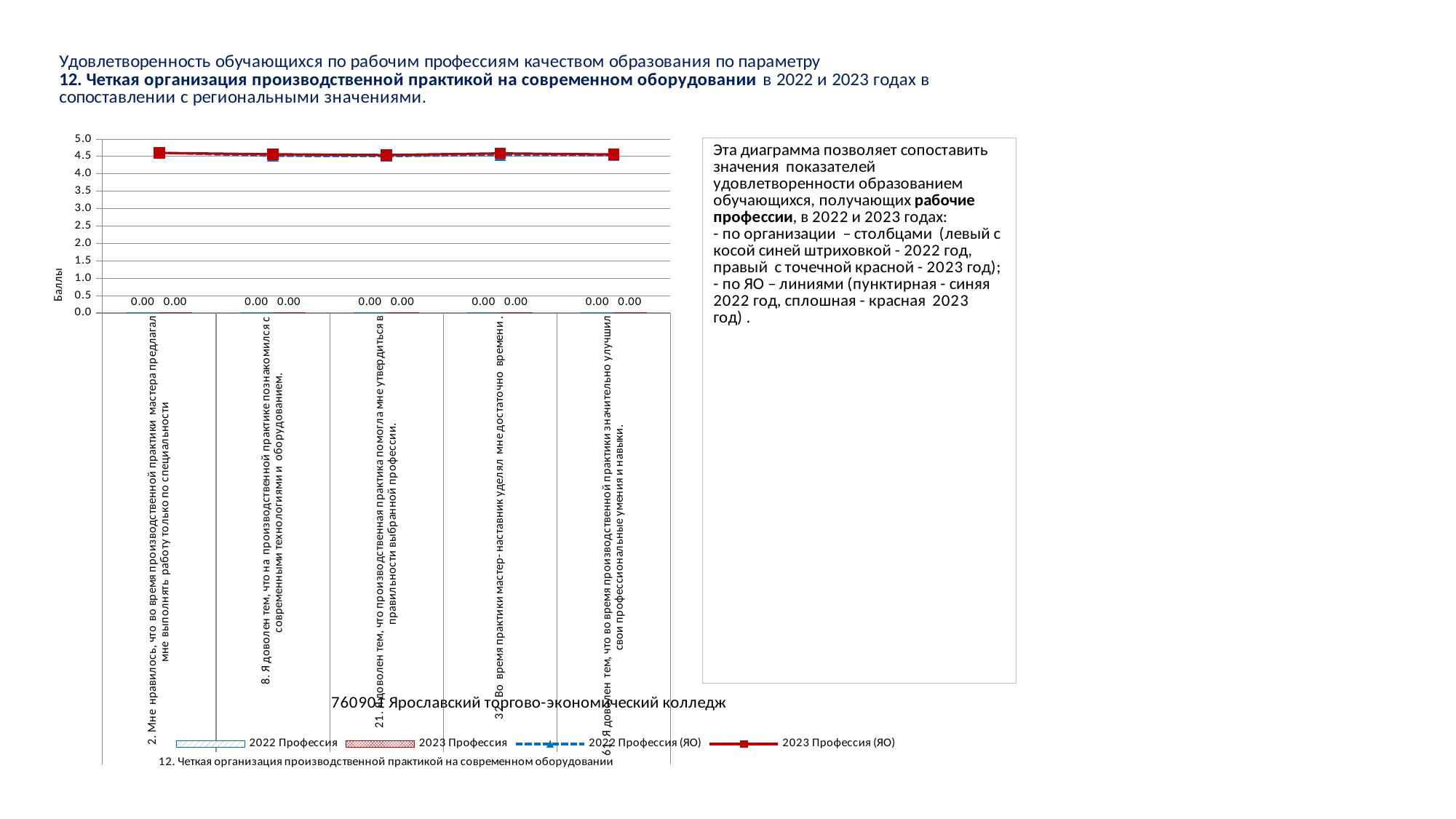
What is the value of the 2022 Профессия bar for category 2 ("Мне нравилось, что во время производственной практики мастера предлагал мне выполнять работу только по специальности")? 0.00 What is the title of the vertical axis of the chart? Баллы What is the difference between the 2022 Профессия and 2023 Профессия bar values for category 32? 0.00 Which series is drawn as a solid red line with square markers according to the legend? 2023 Профессия (ЯО) How many series does the chart legend list? 4 Is the value of the 2022 Профессия (ЯО) line for category 21 greater or less than 4.0? greater How many categories (questions) are shown along the x axis of the chart? 5 What is the value of the 2023 Профессия bar for category 8 ("Я доволен тем, что на производственной практике познакомился с современными технологиями и оборудованием")? 0.00 What kind of chart is shown on the slide? Combined bar and line chart Is the value of the 2023 Профессия (ЯО) line for category 61 greater or less than 5.0? less What is the value of the 2023 Профессия bar for category 61 ("Я доволен тем, что во время производственной практики значительно улучшил свои профессиональные умения и навыки")? 0.00 Is the value of the 2023 Профессия (ЯО) line for category 2 greater or less than 4.0? greater